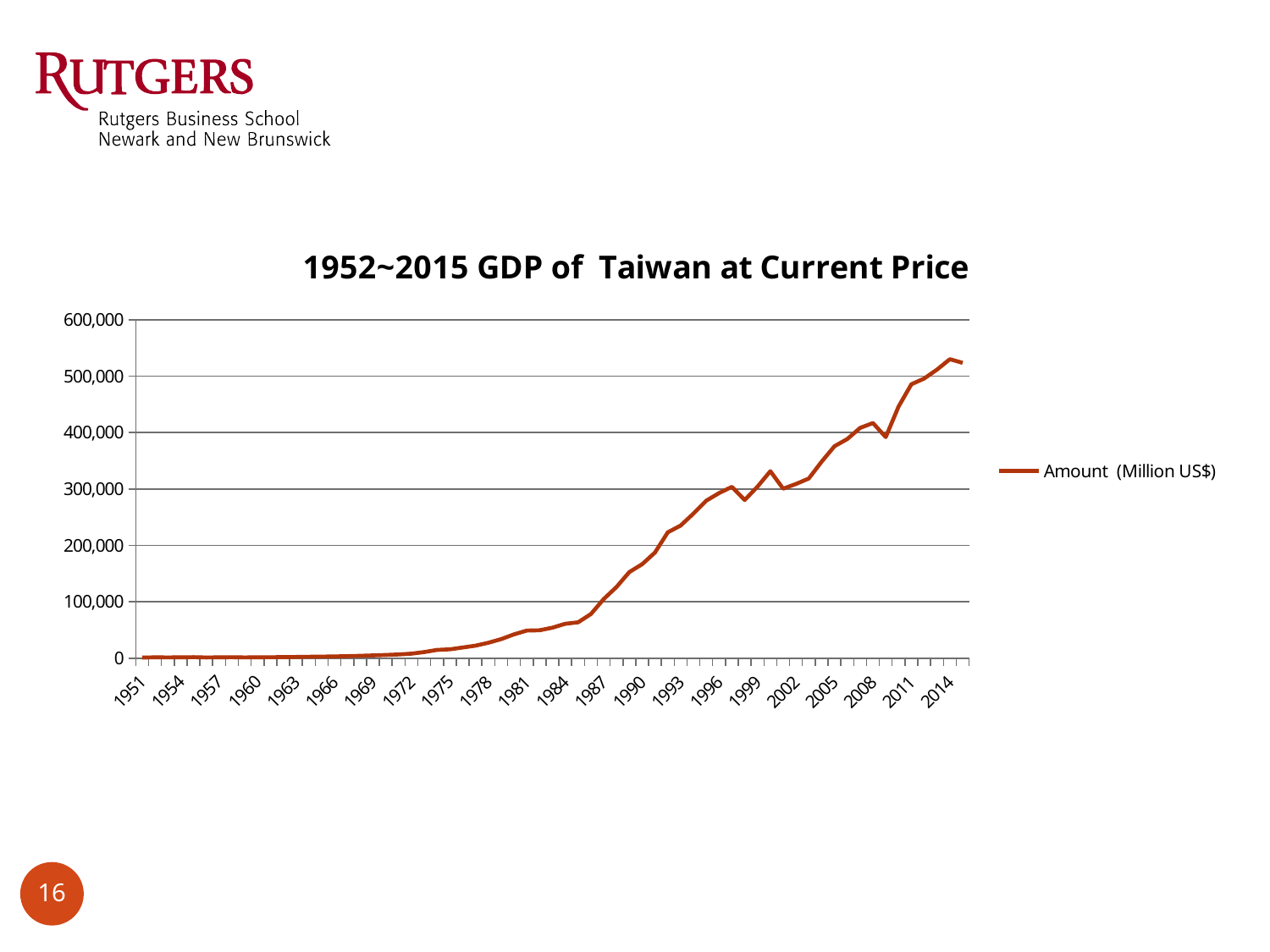
Is the value for 1984 greater or less than 100,000? less Is the value for 1990 greater or less than 100,000? greater Is the value for 2005 greater or less than 300,000? greater What is the title of the chart? 1952~2015 GDP of Taiwan at Current Price What kind of chart is shown on the slide? line chart Which year has the larger value, 1999 or 2014? 2014 Which year has the larger value, 1975 or 1993? 1993 What is the legend entry for the plotted series? Amount (Million US$) How many series does the legend list? 1 Overall, do the values rise or fall from 1951 to 2014 along the x axis? rise